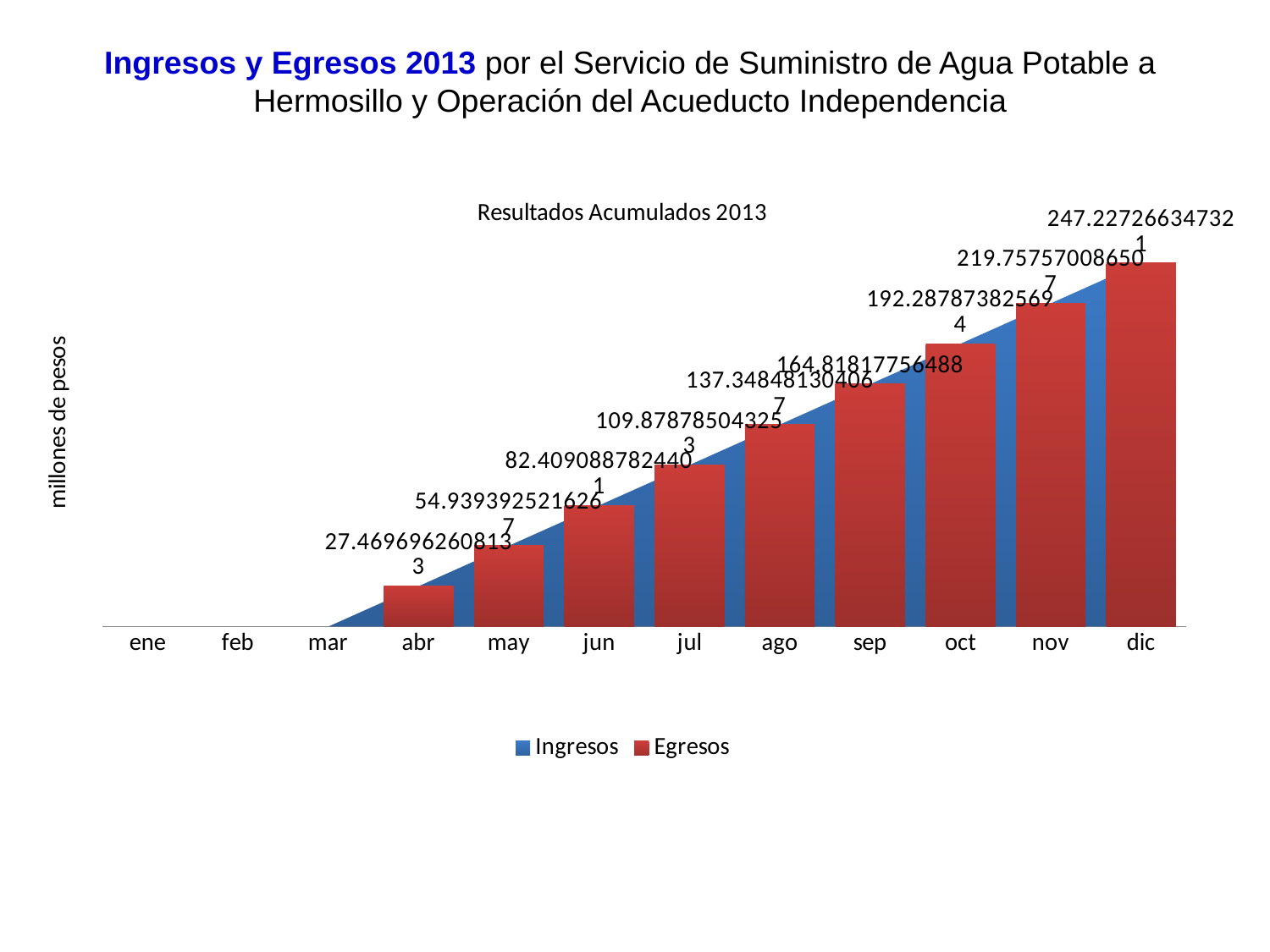
How many months are shown on the x axis? 12 What data label is printed for oct? 192.287873825694 What data label is printed for dic? 247.227266347321 What are the two series named in the legend? Ingresos and Egresos How many series does the legend list? 2 Which month has the lowest non-zero labelled value? abr What is the title of the chart? Resultados Acumulados 2013 Which month has the highest value? dic What data label is printed for abr? 27.4696962608133 Do the values rise or fall from abr to dic? rise Which is larger, the value for nov or the value for jul? nov What data label is printed for ago? 137.348481304067